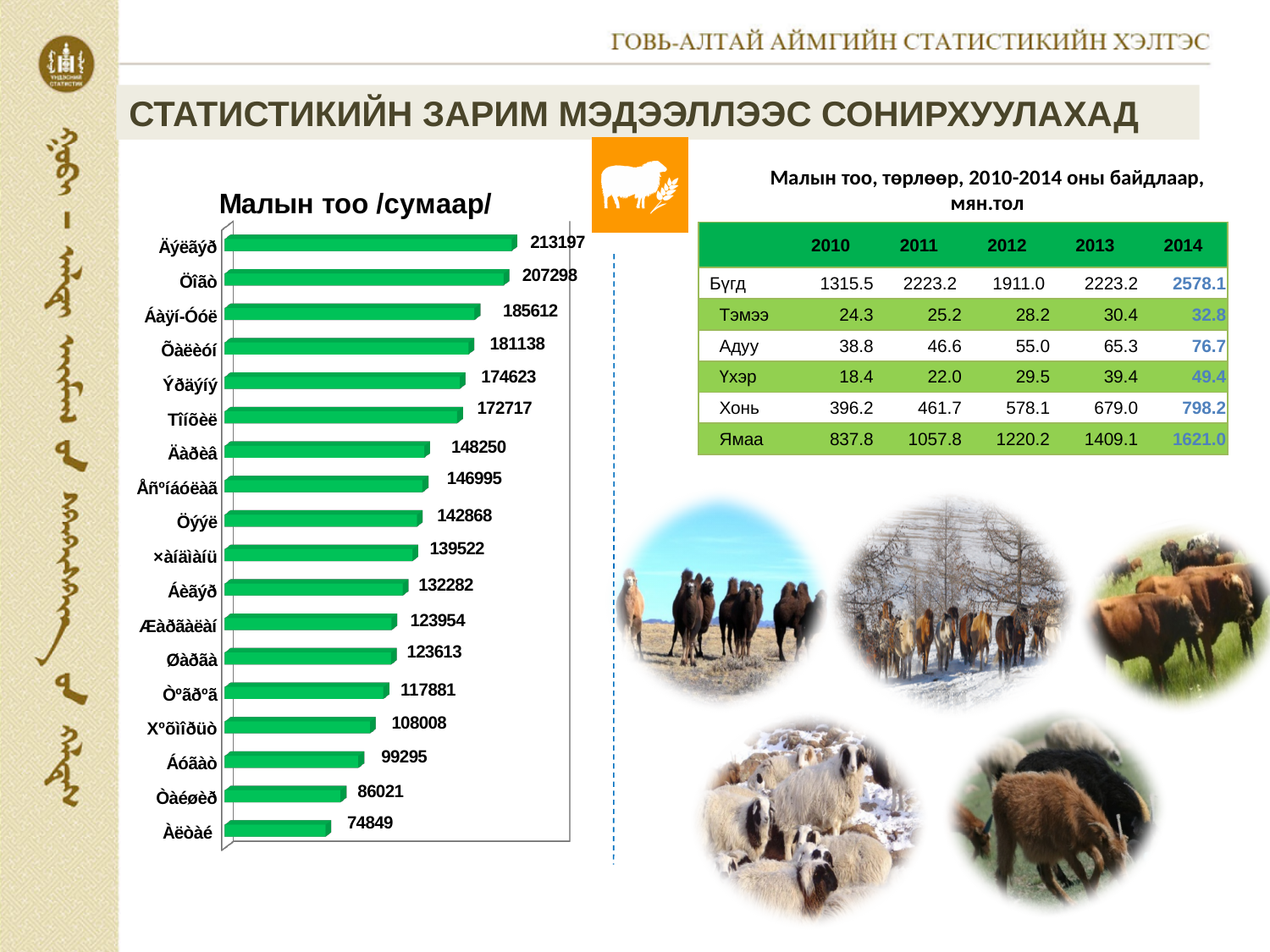
Do the bar values increase or decrease going from the top of the chart to the bottom? decrease What is the highest value shown in the chart? 213197 What is the lowest value shown in the chart? 74849 How many bars (categories) does the chart show? 18 What is the value of the third bar from the top of the chart? 185612 What kind of chart is shown on the slide? bar chart What is the difference between the top two bars in the chart (213197 and 207298)? 5899 What is the value of the fourth bar from the bottom of the chart? 108008 What is the title of the chart on the left of the slide? Малын тоо /сумаар/ Which is larger: the value of the second bar from the top or the third bar from the top? the second bar from the top (207298) What is the difference between the highest and lowest values in the chart? 138348 What is the value of the second bar from the top of the chart? 207298